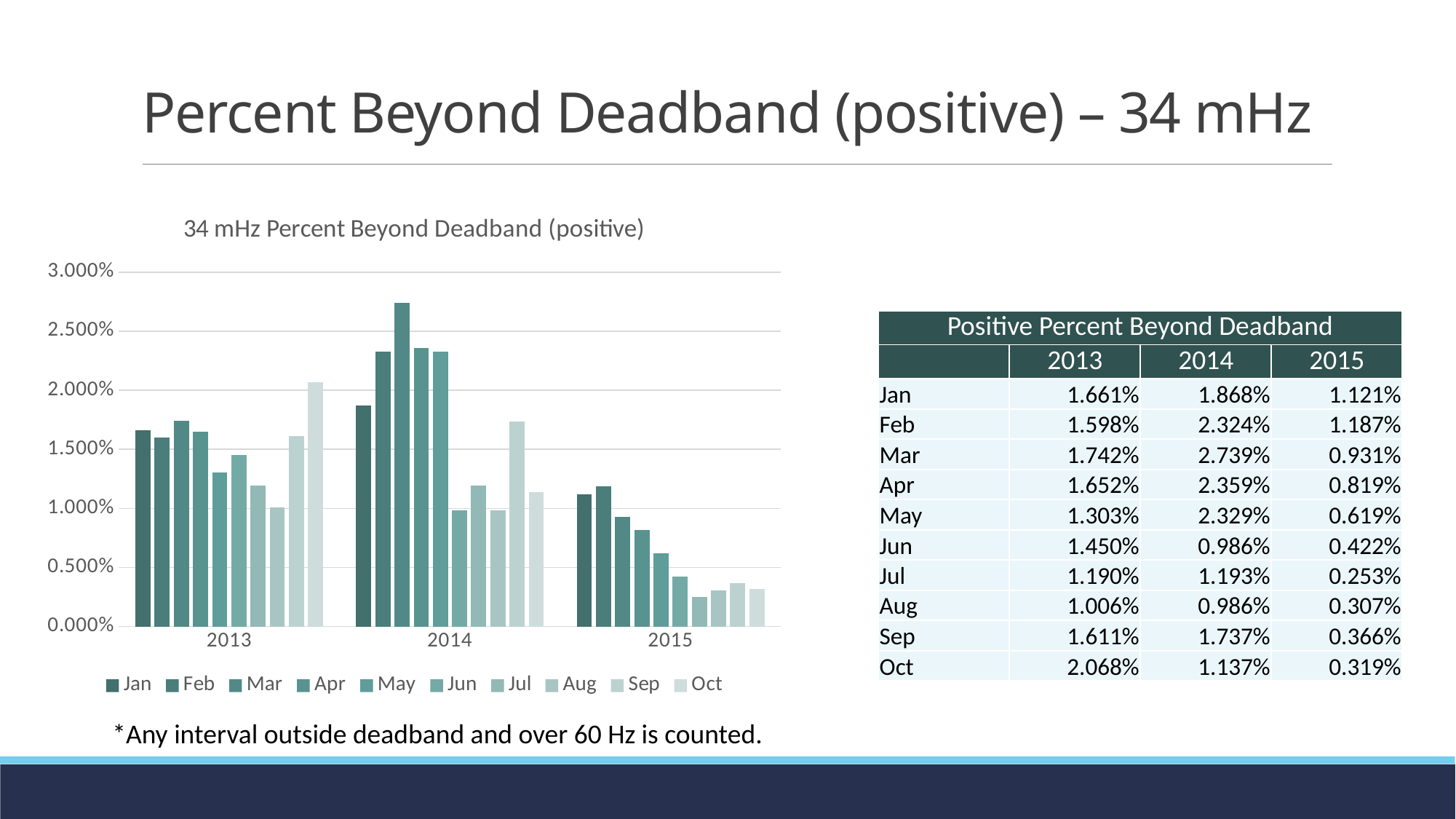
How many series does the chart legend list? 10 Which month has the lowest value in 2015? Jul Which month has the highest value in 2014? Mar What is the title of the chart? 34 mHz Percent Beyond Deadband (positive) How many year categories are shown on the x axis of the chart? 3 Which is larger, the Sep value for 2013 or the Sep value for 2014? 2014 What is the value for Oct in 2013? 2.068% What is the value for Mar in 2014? 2.739% Is the value for Mar in 2014 greater or less than 2.500%? greater What is the difference between the Jan values for 2014 and 2015? 0.747% What is the value for Jul in 2015? 0.253% What kind of chart is shown on the slide? bar chart